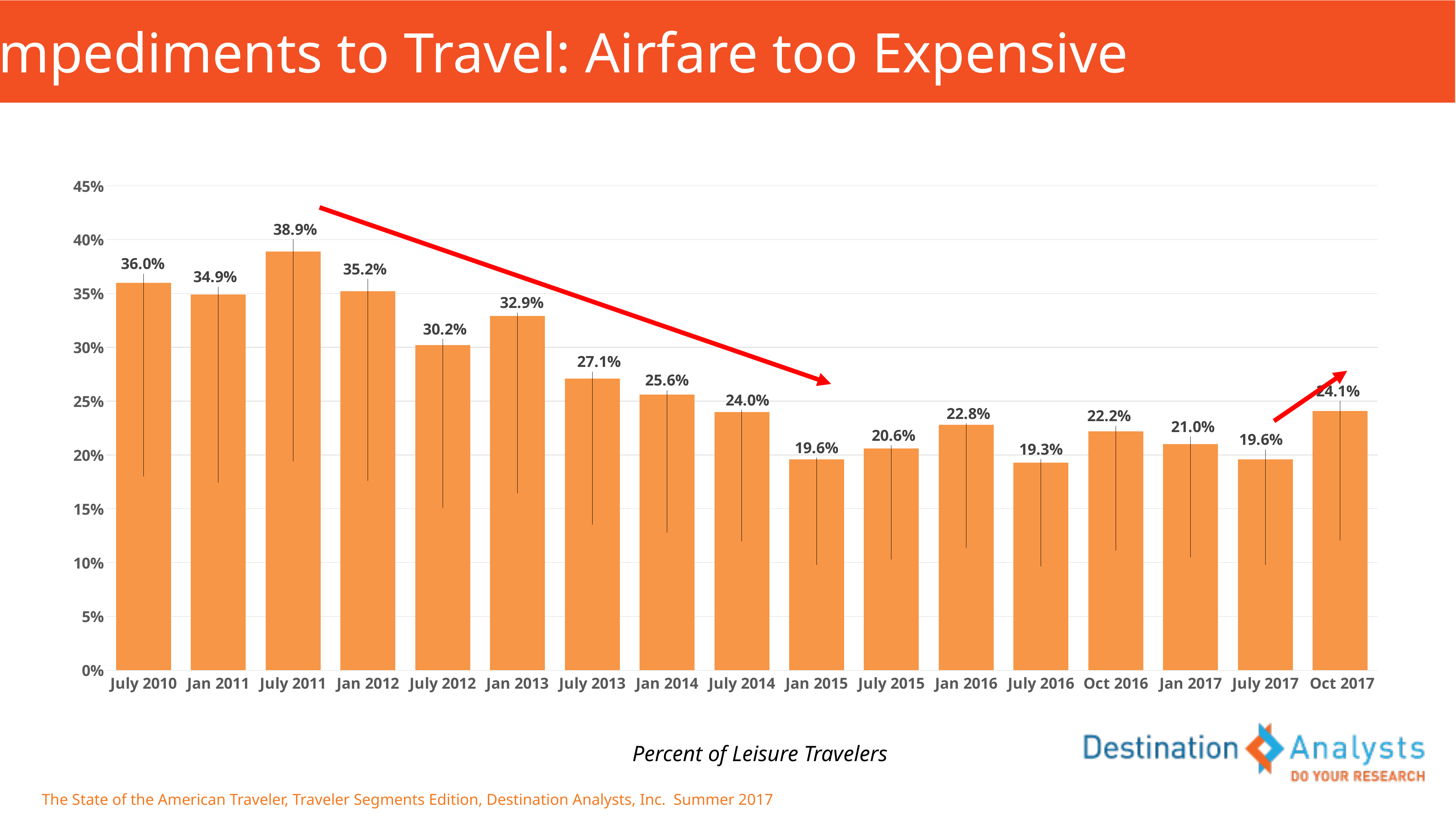
Which is larger, the value for Jan 2013 or the value for July 2012? Jan 2013 Which period has the lowest value? July 2016 Which period has the highest value? July 2011 Do the values generally rise or fall from July 2010 to Jan 2015? fall What is the difference between the values for Jan 2016 and July 2016? 3.5% Is the value for Oct 2017 greater or less than 20%? greater What is the difference between the values for July 2010 and July 2014? 12.0% What is the value for July 2011? 38.9% How many periods are shown on the x axis? 17 What kind of chart is shown on the slide? bar chart What is the value for Oct 2016? 22.2% What is the value for Jan 2015? 19.6%